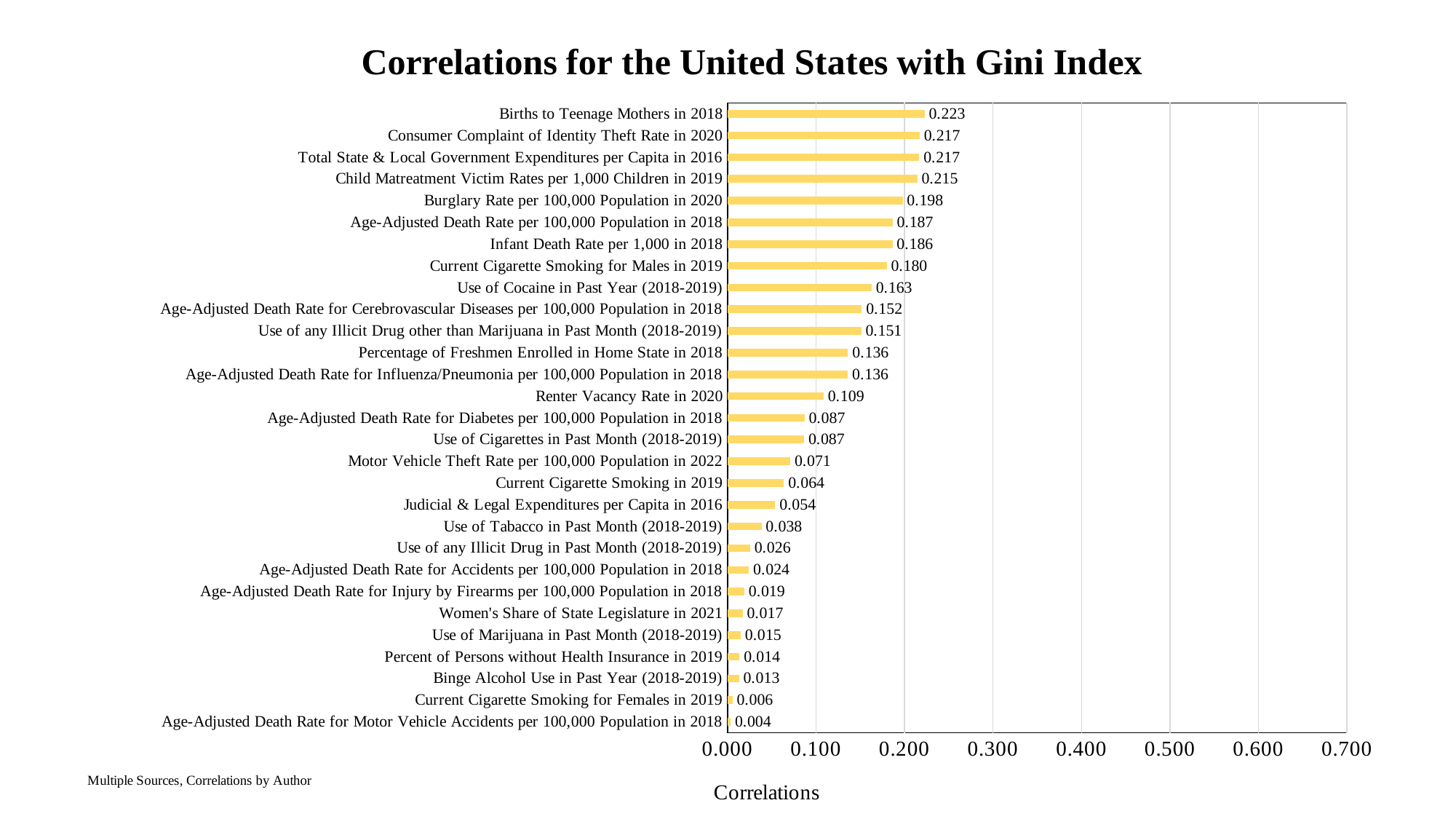
What is the correlation value for Use of Cocaine in Past Year (2018-2019)? 0.163 Which has a larger correlation: Infant Death Rate per 1,000 in 2018 or Judicial & Legal Expenditures per Capita in 2016? Infant Death Rate per 1,000 in 2018 What is the label of the horizontal axis? Correlations Is the correlation for Child Matreatment Victim Rates per 1,000 Children in 2019 greater or less than 0.200? greater What is the title of the chart? Correlations for the United States with Gini Index How many categories are plotted in the chart? 29 Which category has the lowest correlation with the Gini Index? Age-Adjusted Death Rate for Motor Vehicle Accidents per 100,000 Population in 2018 Which category has the highest correlation with the Gini Index? Births to Teenage Mothers in 2018 What is the correlation value for Renter Vacancy Rate in 2020? 0.109 What is the difference between the correlation for Burglary Rate per 100,000 Population in 2020 and Current Cigarette Smoking for Males in 2019? 0.018 What kind of chart is shown on the slide? Bar chart What is the correlation value for Births to Teenage Mothers in 2018? 0.223